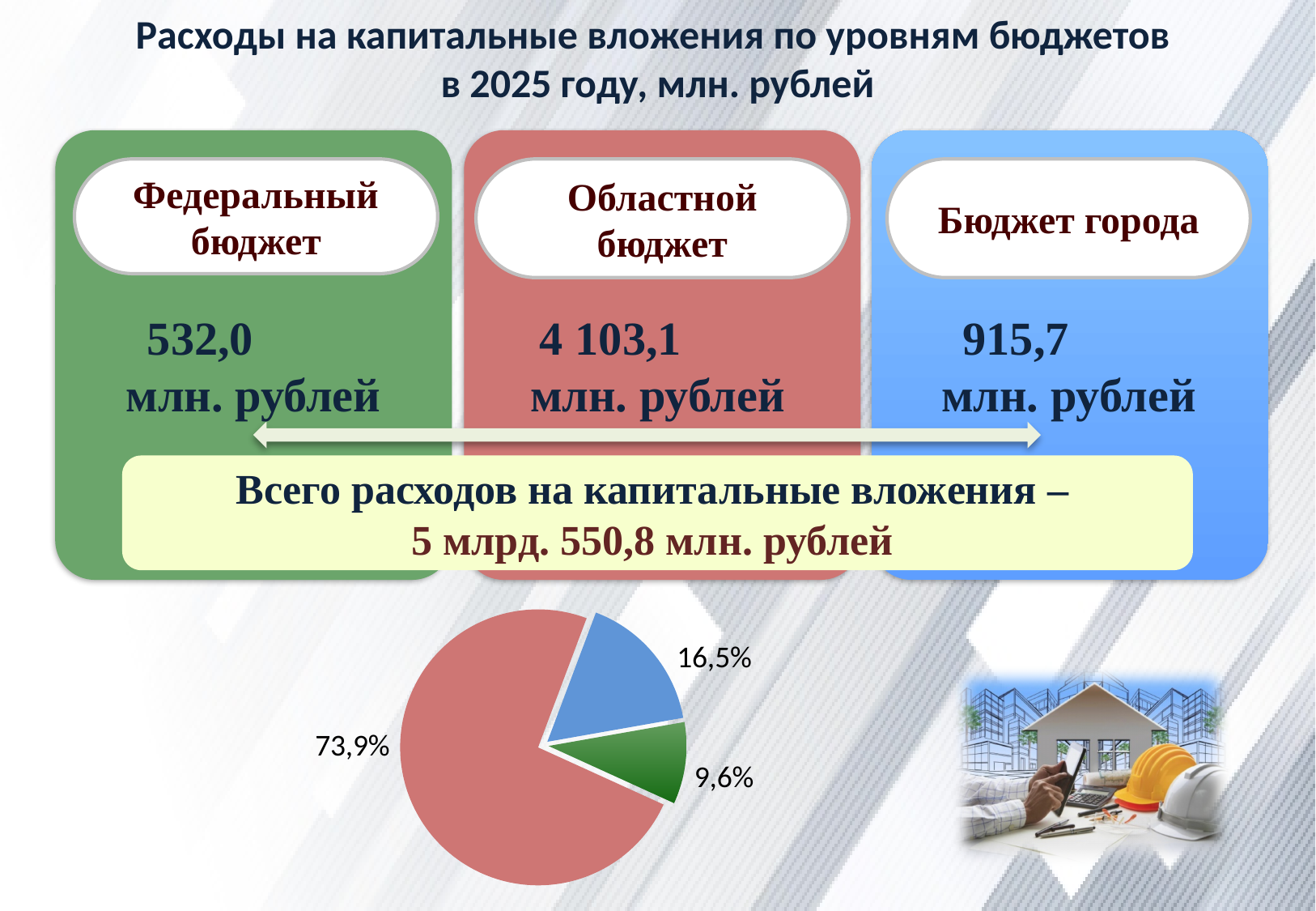
What is the difference in percentage points between the blue slice (16,5%) and the green slice (9,6%) of the pie chart? 6,9 What share does the red slice of the pie chart represent? 73,9% What is the share of the smallest slice in the pie chart? 9,6% What kind of chart is shown at the bottom of the slide? pie chart What is the title of the slide containing the pie chart? Расходы на капитальные вложения по уровням бюджетов в 2025 году, млн. рублей What share does the blue slice of the pie chart represent? 16,5% How many slices does the pie chart have? 3 By how many percentage points does the largest slice of the pie chart exceed the blue slice? 57,4 What share does the green slice of the pie chart represent? 9,6% Which slice of the pie chart is larger, the blue one or the green one? the blue one What is the share of the largest slice in the pie chart? 73,9% Does the red slice of the pie chart account for more or less than half of the total? more